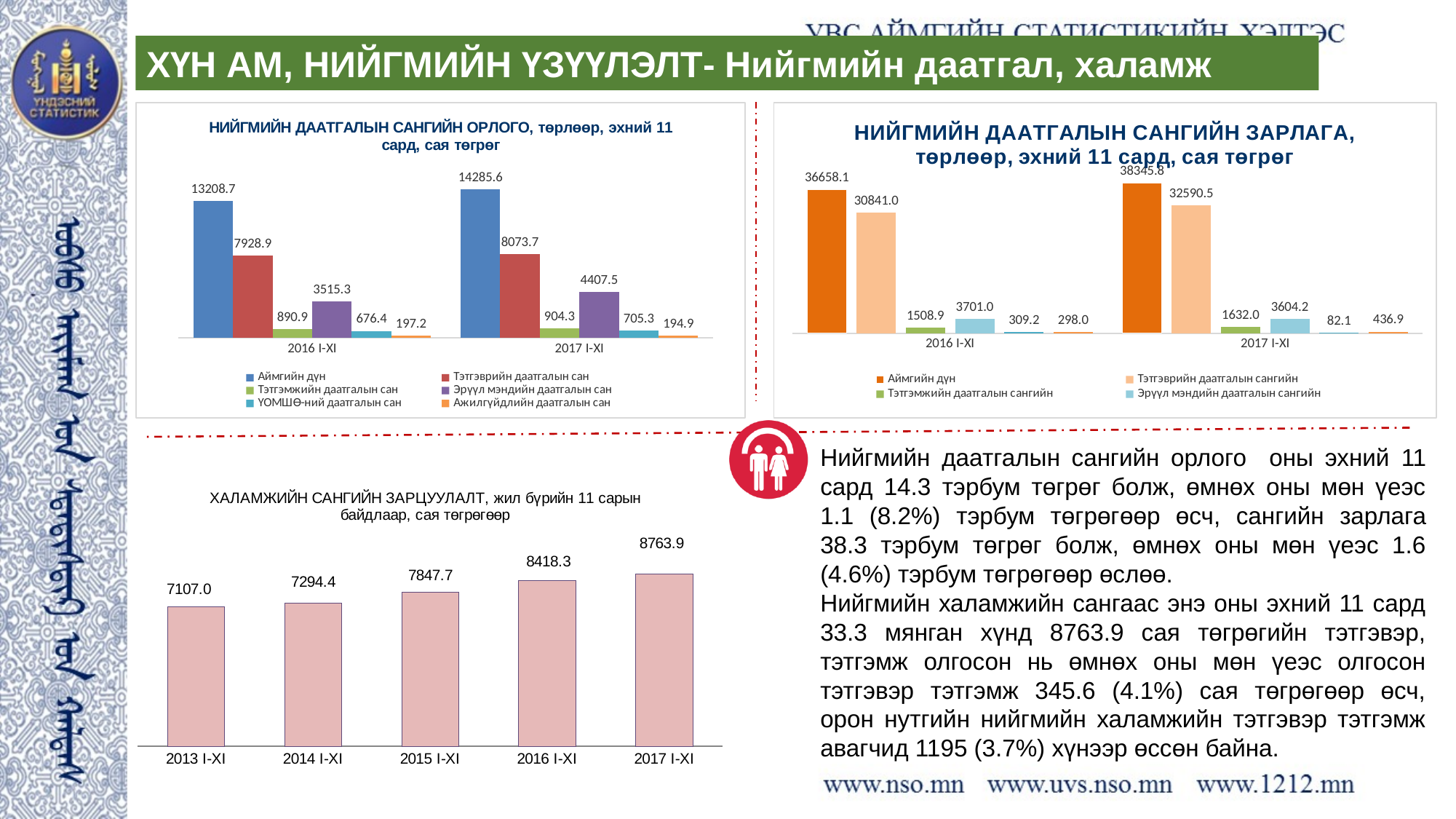
In the top-left chart 'НИЙГМИЙН ДААТГАЛЫН САНГИЙН ОРЛОГО', which is larger for 2017 I-XI: Тэтгэврийн даатгалын сан or Эрүүл мэндийн даатгалын сан? Тэтгэврийн даатгалын сан In the chart titled 'ХАЛАМЖИЙН САНГИЙН ЗАРЦУУЛАЛТ', how many years are shown? 5 In the chart titled 'ХАЛАМЖИЙН САНГИЙН ЗАРЦУУЛАЛТ', which year has the lowest value? 2013 I-XI In the top-left chart 'НИЙГМИЙН ДААТГАЛЫН САНГИЙН ОРЛОГО', what is the value of Эрүүл мэндийн даатгалын сан for 2016 I-XI? 3515.3 In the top-left chart 'НИЙГМИЙН ДААТГАЛЫН САНГИЙН ОРЛОГО', how many series does the legend list? 6 In the chart titled 'ХАЛАМЖИЙН САНГИЙН ЗАРЦУУЛАЛТ', do the values rise or fall from 2013 I-XI to 2017 I-XI? rise In the chart titled 'ХАЛАМЖИЙН САНГИЙН ЗАРЦУУЛАЛТ', what is the value for 2017 I-XI? 8763.9 In the top-right chart 'НИЙГМИЙН ДААТГАЛЫН САНГИЙН ЗАРЛАГА', what is the value of Аймгийн дүн for 2016 I-XI? 36658.1 In the top-left chart 'НИЙГМИЙН ДААТГАЛЫН САНГИЙН ОРЛОГО', what is the value of Аймгийн дүн for 2017 I-XI? 14285.6 In the top-right chart 'НИЙГМИЙН ДААТГАЛЫН САНГИЙН ЗАРЛАГА', what is the value of Тэтгэврийн даатгалын сангийн for 2017 I-XI? 32590.5 What type of chart is the bottom-left chart 'ХАЛАМЖИЙН САНГИЙН ЗАРЦУУЛАЛТ'? bar chart In the chart titled 'ХАЛАМЖИЙН САНГИЙН ЗАРЦУУЛАЛТ', what is the difference between the 2017 I-XI and 2016 I-XI values? 345.6